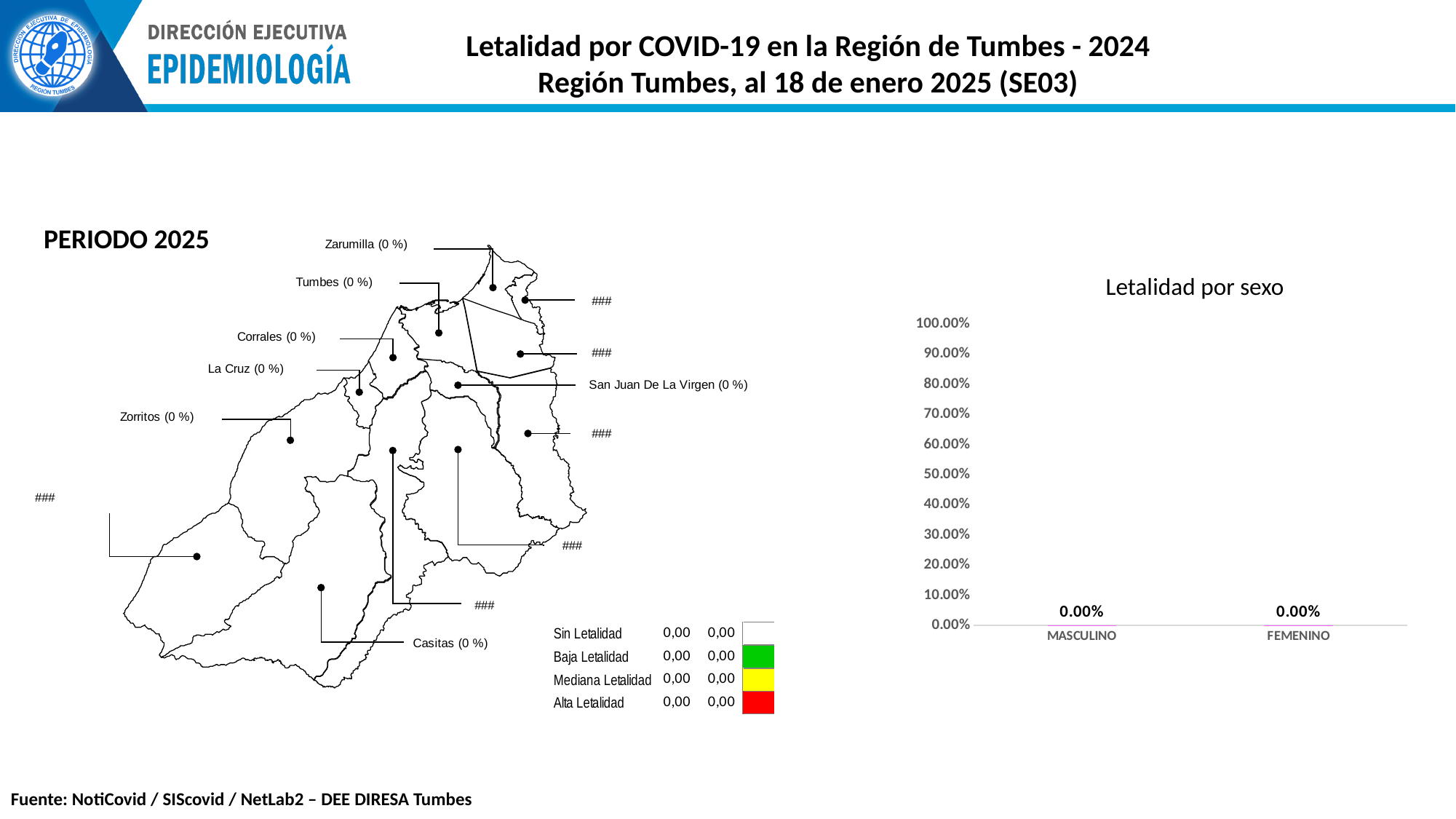
In the 'Letalidad por sexo' chart, what is the value for FEMENINO? 0.00% What is the title of the bar chart on the right side of the slide? Letalidad por sexo In the 'Letalidad por sexo' chart, is the value for MASCULINO greater or less than 50.00%? less In the 'Letalidad por sexo' chart, what is the value for MASCULINO? 0.00% How many categories are shown on the x axis of the 'Letalidad por sexo' chart? 2 In the 'Letalidad por sexo' chart, is the value for FEMENINO greater or less than 10.00%? less What kind of chart is 'Letalidad por sexo'? bar chart What is the highest tick value shown on the y axis of the 'Letalidad por sexo' chart? 100.00% In the 'Letalidad por sexo' chart, is the value for MASCULINO larger than, smaller than, or equal to the value for FEMENINO? equal In the 'Letalidad por sexo' chart, what is the difference between the values for MASCULINO and FEMENINO? 0.00%